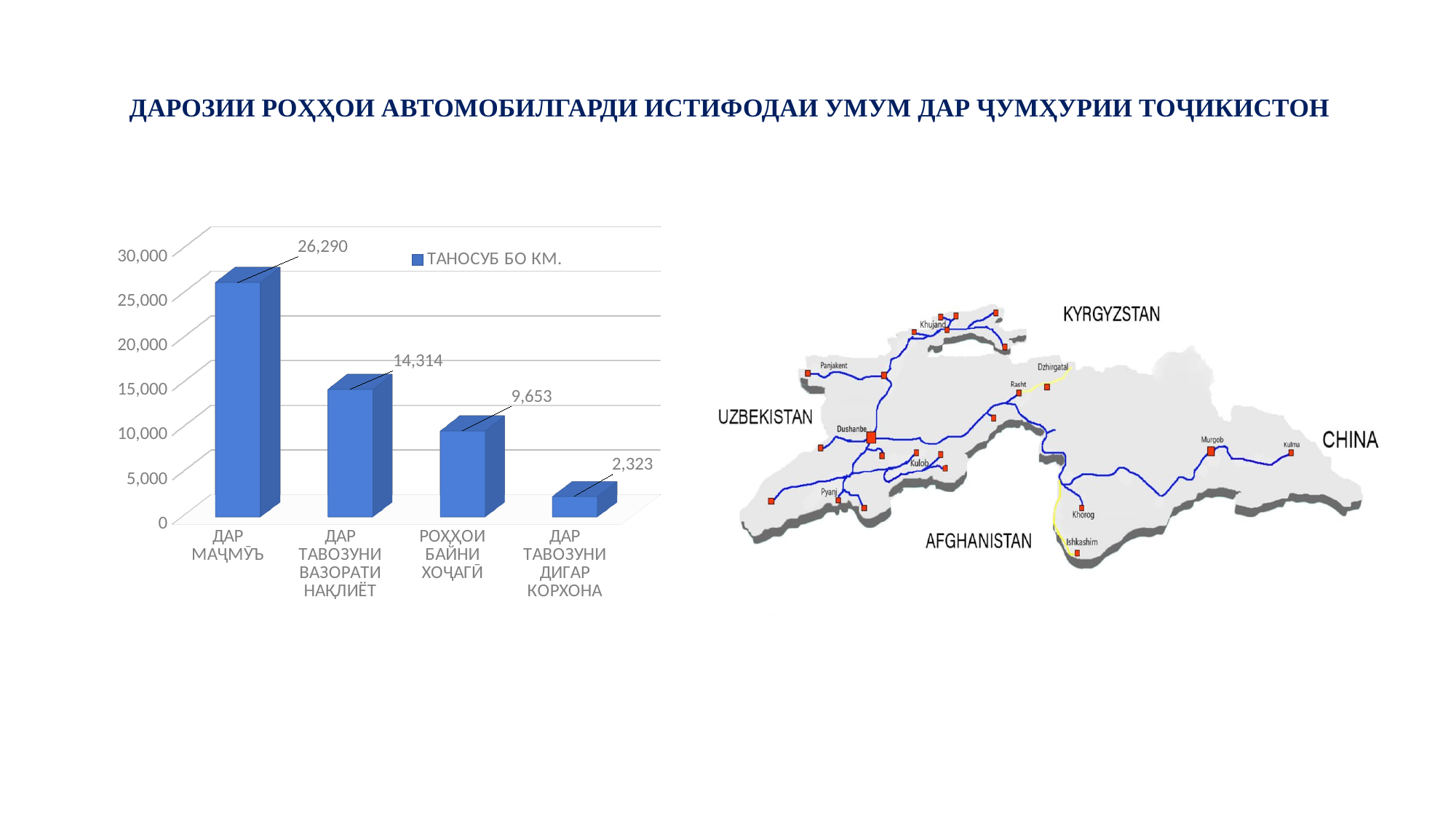
What series name does the legend show? ТАНОСУБ БО КМ. Which category has the lowest value? ДАР ТАВОЗУНИ ДИГАР КОРХОНА What is the value for ДАР ТАВОЗУНИ ДИГАР КОРХОНА? 2,323 Is the value for ДАР ТАВОЗУНИ ВАЗОРАТИ НАҚЛИЁТ greater or less than 10,000? greater Which category has the highest value? ДАР МАҶМӮЪ What is the value for ДАР МАҶМӮЪ? 26,290 How many categories are shown on the chart? 4 What kind of chart is shown on the slide? bar chart What is the value for РОҲҲОИ БАЙНИ ХОҶАГӢ? 9,653 Which is larger, the value for РОҲҲОИ БАЙНИ ХОҶАГӢ or the value for ДАР ТАВОЗУНИ ДИГАР КОРХОНА? РОҲҲОИ БАЙНИ ХОҶАГӢ What is the difference between the values for ДАР ТАВОЗУНИ ВАЗОРАТИ НАҚЛИЁТ and РОҲҲОИ БАЙНИ ХОҶАГӢ? 4,661 What is the value for ДАР ТАВОЗУНИ ВАЗОРАТИ НАҚЛИЁТ? 14,314